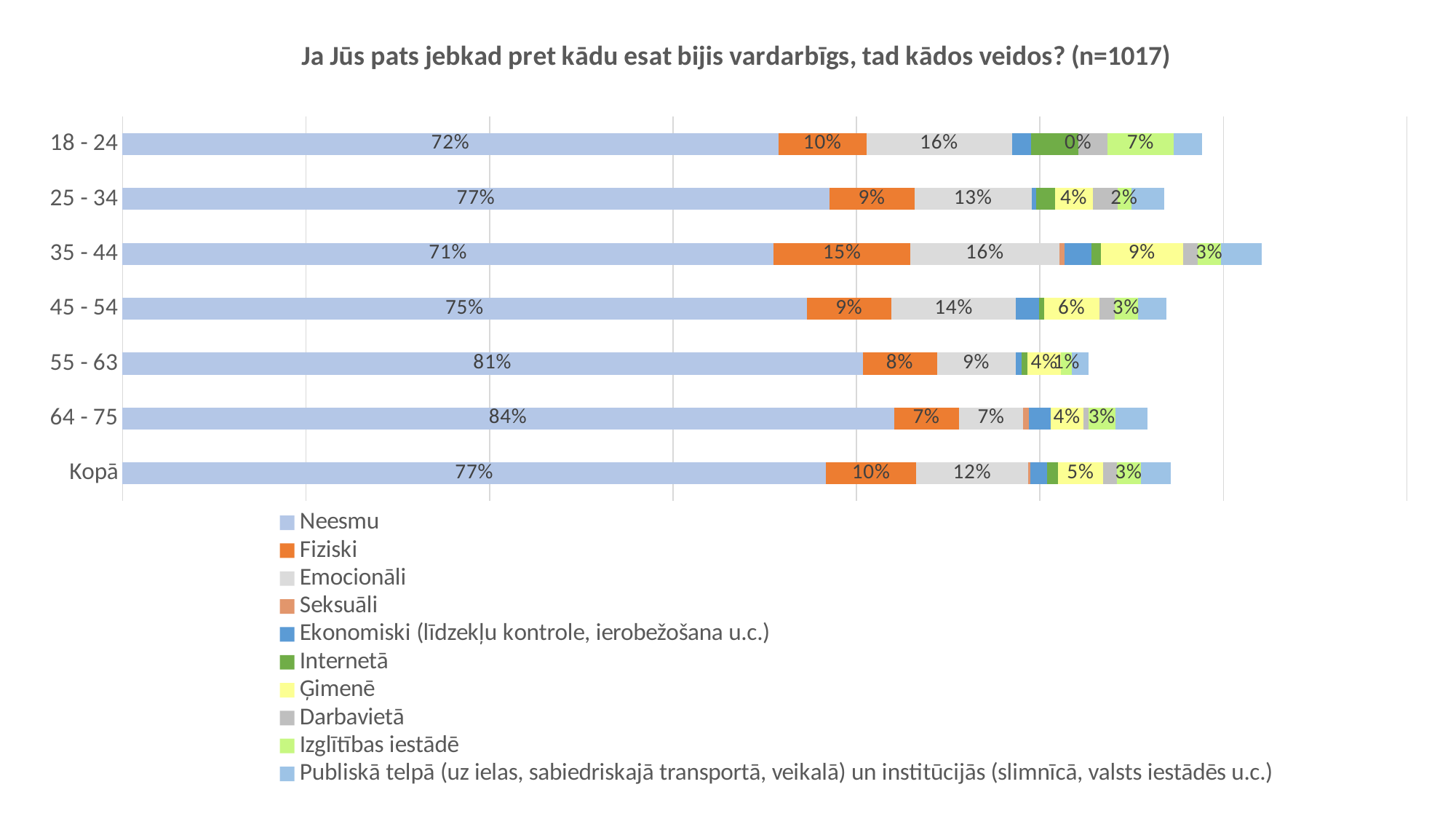
Which age group has the highest Neesmu value? 64 - 75 What is the difference in percentage points between the Neesmu values for 64 - 75 and 35 - 44? 13 How many age-group categories (including Kopā) are shown on the chart? 7 What kind of chart is shown on the slide? Stacked bar chart Which age group has the highest Fiziski value? 35 - 44 What is the Neesmu value for the 25 - 34 age group? 77% How many series does the legend list? 10 What is the Neesmu value for the 64 - 75 age group? 84% Which age group has the lowest Neesmu value? 35 - 44 What is the Fiziski value for the 35 - 44 age group? 15% What is the Emocionāli value for the Kopā row? 12% Which is larger, the Emocionāli value for 45 - 54 or for 55 - 63? 45 - 54